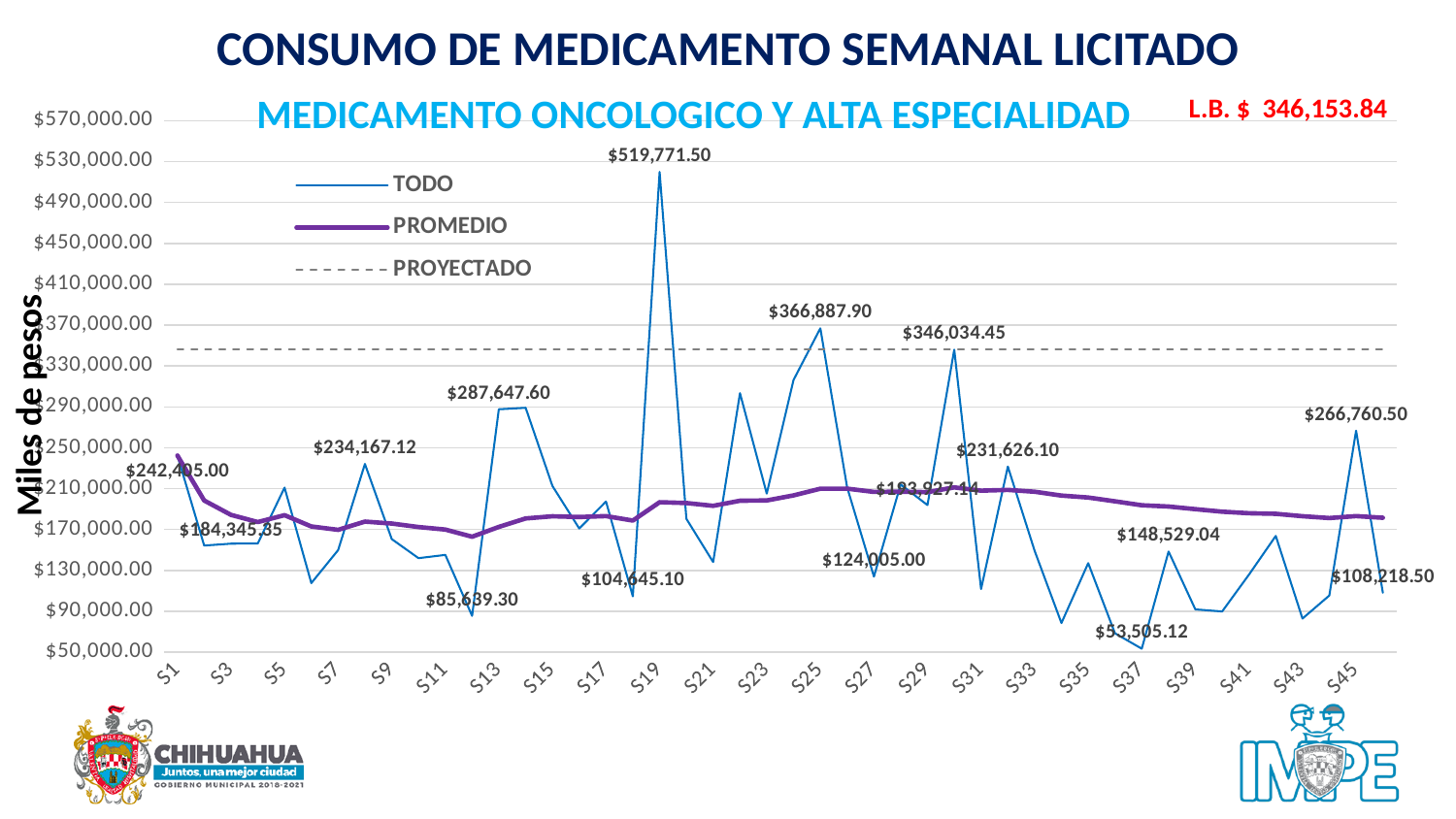
What is the L.B. value shown on the slide? $ 346,153.84 What are the three series named in the legend? TODO, PROMEDIO, PROYECTADO Is the dashed PROYECTADO line greater or less than $330,000.00? greater How many series does the legend list? 3 What is the difference between the labeled peak of $519,771.50 and the labeled value of $366,887.90? $152,883.60 Is the value of the TODO line at S19 greater or less than $490,000.00? greater What is the highest value labeled on the TODO line? $519,771.50 What is the title of the vertical axis? Miles de pesos What is the lowest value labeled on the TODO line? $53,505.12 What kind of chart is shown on the slide? line chart Is the value of the TODO line at S37 greater or less than $90,000.00? less Which labeled value is larger, $287,647.60 or $266,760.50? $287,647.60